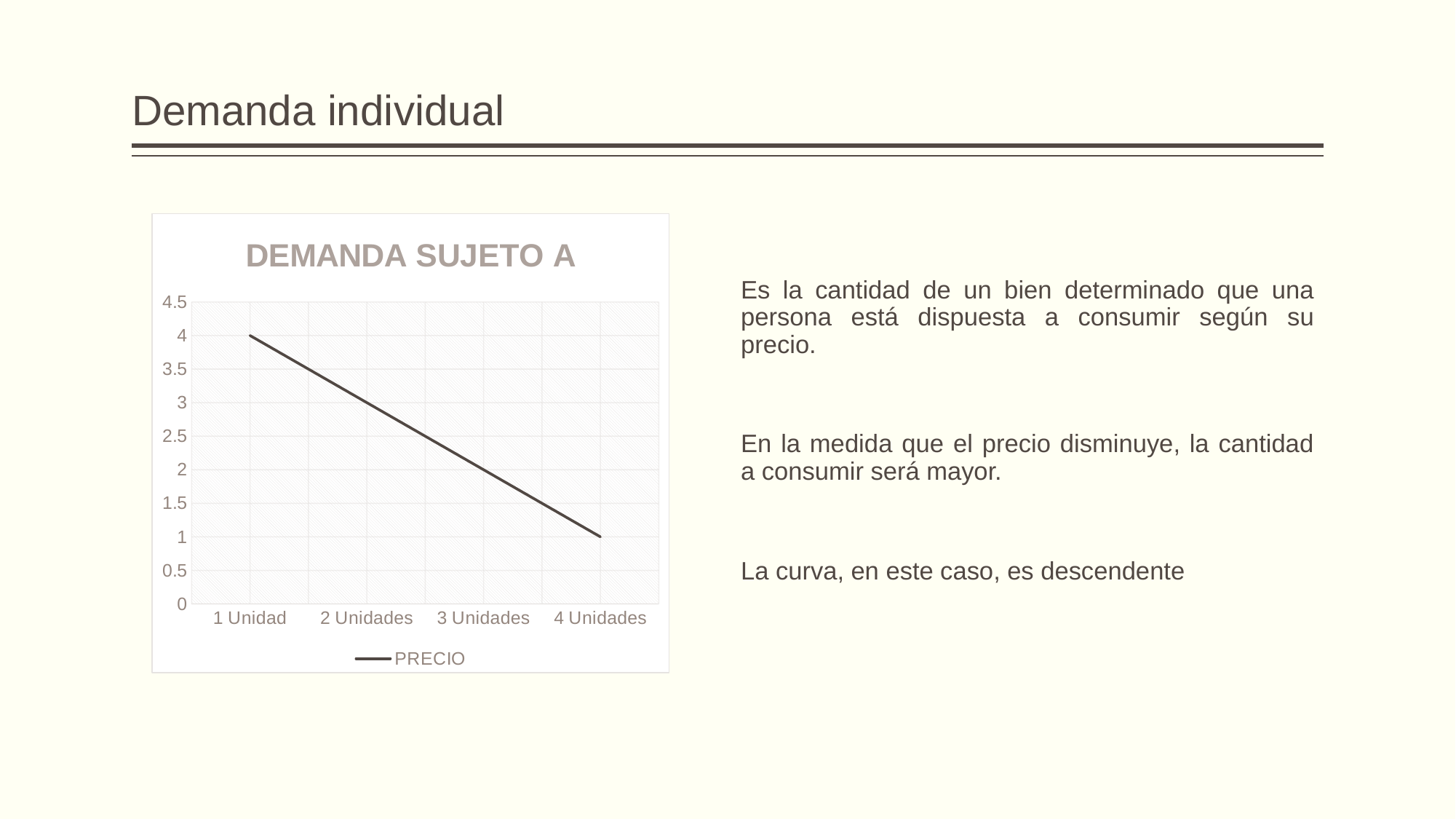
Which category has the lowest PRECIO value? 4 Unidades What is the difference between the PRECIO value for 1 Unidad and for 4 Unidades? 3 What is the title of the chart? DEMANDA SUJETO A Which category has the highest PRECIO value? 1 Unidad What is the PRECIO value for 2 Unidades? 3 Do the PRECIO values rise or fall from 1 Unidad to 4 Unidades? fall What is the name of the series shown in the chart legend? PRECIO What kind of chart is shown on the slide? line chart What is the PRECIO value for 1 Unidad? 4 How many categories are shown on the x axis of the chart? 4 How many series does the chart legend list? 1 What is the PRECIO value for 4 Unidades? 1